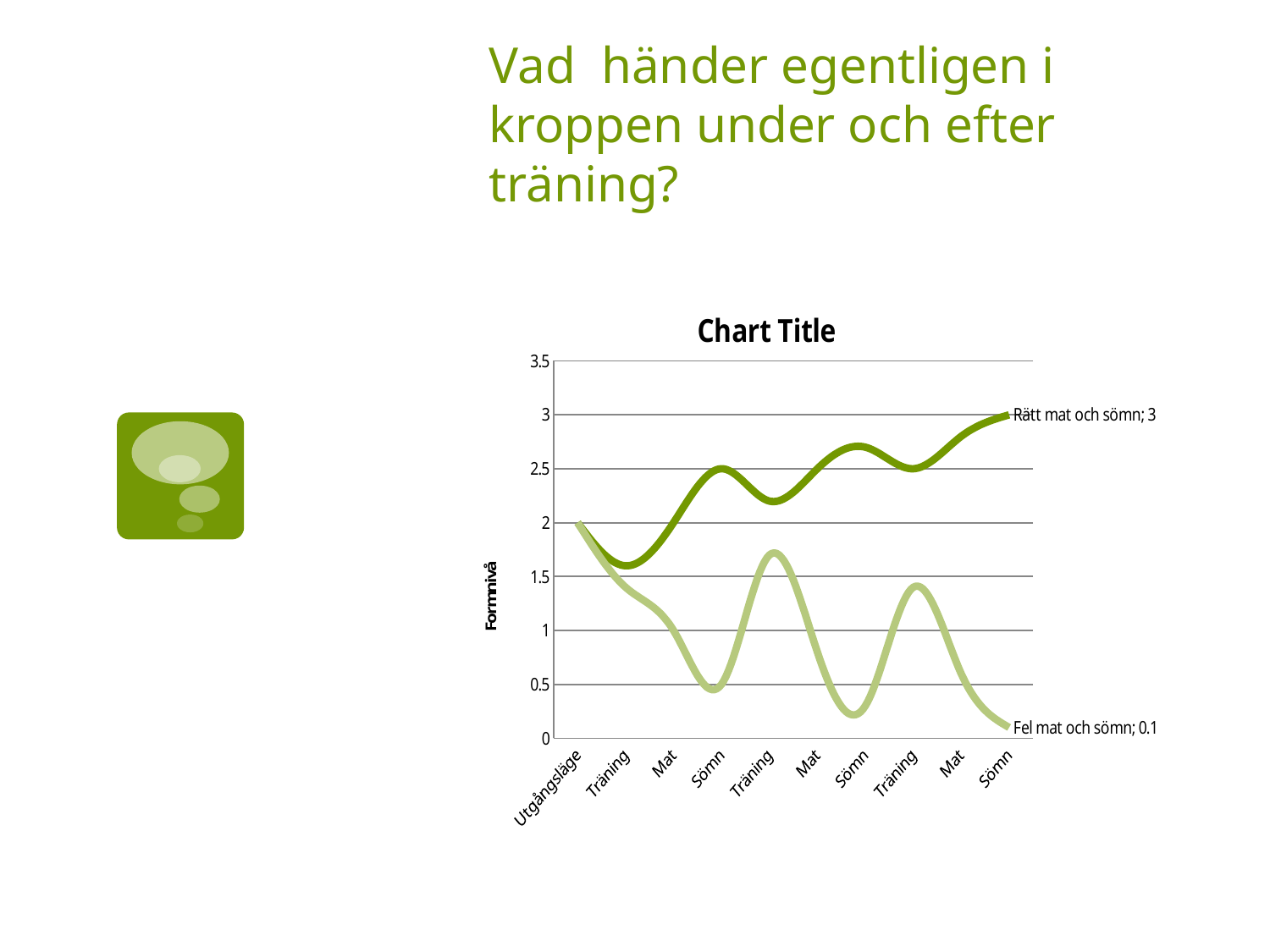
How many series are plotted in the chart? 2 Is the value of "Fel mat och sömn" at the first Sömn point greater or less than 1? less How many categories are on the x axis of the chart? 10 Is the value of "Rätt mat och sömn" at the second Träning point greater or less than 2? greater Does the "Rätt mat och sömn" series rise or fall overall from Utgångsläge to the last Sömn? Rise What is the final value of the "Fel mat och sömn" series at the last Sömn point? 0.1 What is the difference between the final values of "Rätt mat och sömn" and "Fel mat och sömn"? 2.9 What is the title of the vertical axis of the chart? Formnivå What is the final value of the "Rätt mat och sömn" series at the last Sömn point? 3 Does the "Fel mat och sömn" series rise or fall overall from Utgångsläge to the last Sömn? Fall What kind of chart is shown on the slide? Line chart At the last Sömn point, which series has the larger value, "Rätt mat och sömn" or "Fel mat och sömn"? Rätt mat och sömn